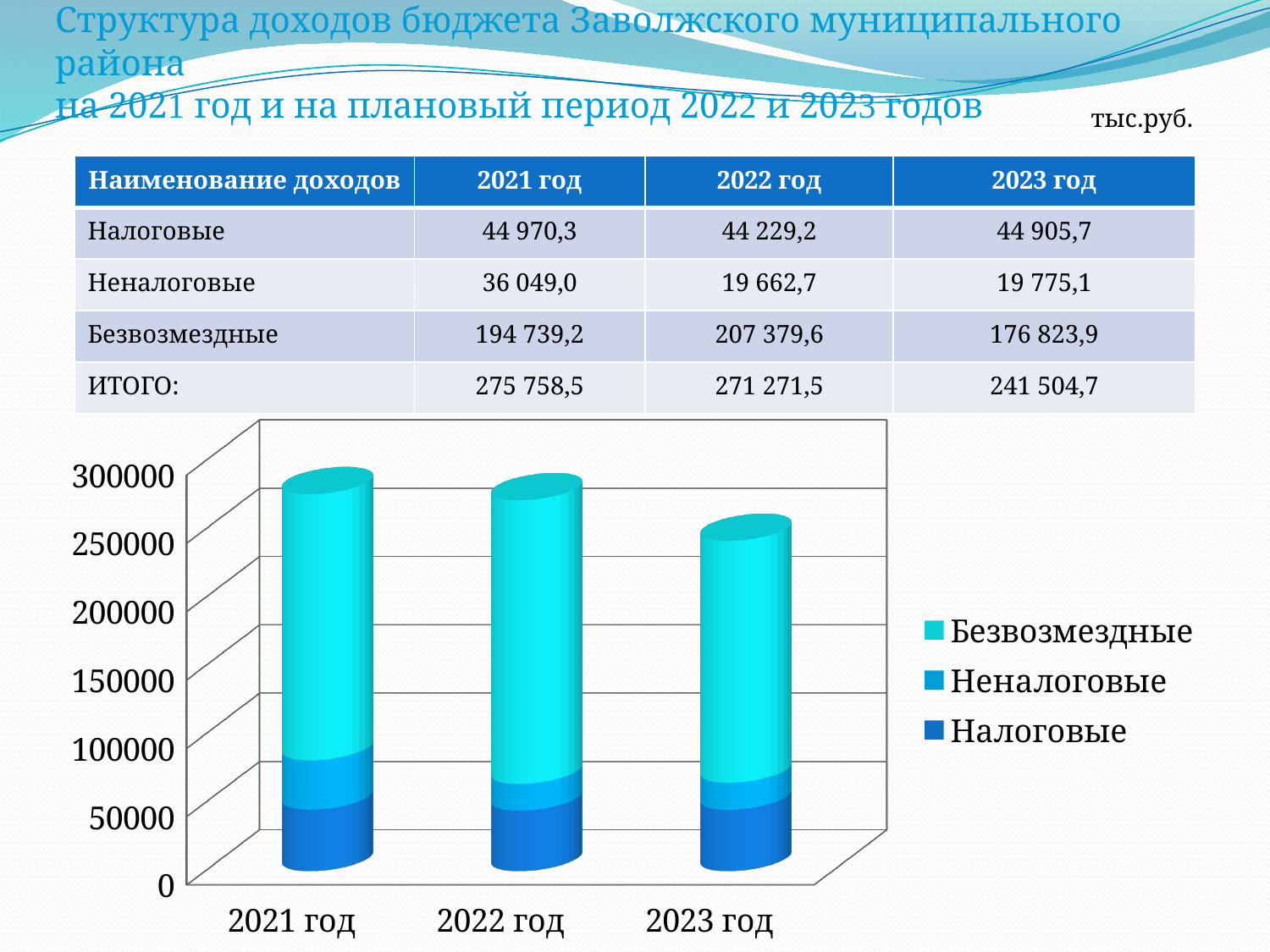
How many series does the chart legend list? 3 Which year has the tallest stacked bar in the chart? 2021 год What kind of chart is shown on the slide? stacked bar chart Which year has the shortest stacked bar in the chart? 2023 год Is the total stacked bar for 2021 год greater or less than 250000? greater Do the total bar heights rise or fall from 2021 год to 2023 год? fall What is the total of the stacked bar for 2022 год, as printed in the table (ИТОГО)? 271 271,5 Which is larger, the Неналоговые value for 2021 год or for 2022 год? 2021 год Is the total stacked bar for 2023 год greater or less than 250000? less What is the value of the Безвозмездные segment for 2023 год? 176 823,9 How many years (categories) are shown on the x axis of the chart? 3 Which legend entry is shown in the darkest blue colour? Налоговые